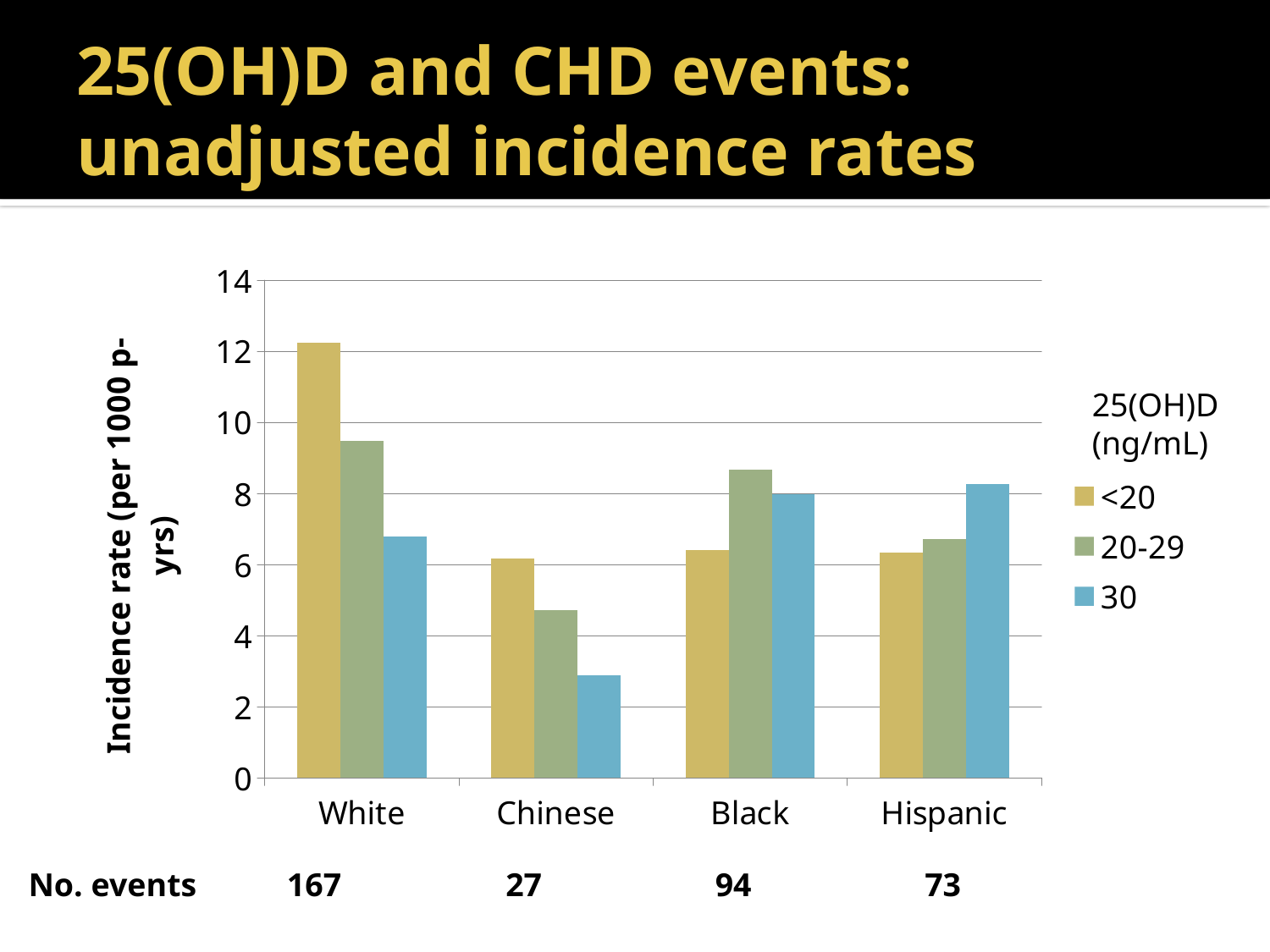
How many race/ethnicity categories are shown on the x axis? 4 Is the incidence rate for White in the <20 ng/mL group greater or less than 10? greater What is the title of the chart's legend? 25(OH)D (ng/mL) How many events are listed for the Black category? 94 For the Hispanic category, do the incidence rates rise or fall going from the <20 group to the 30 group? rise Is the incidence rate for Chinese in the 30 ng/mL group greater or less than 4? less How many 25(OH)D series does the legend list? 3 Which category has the lowest incidence rate for the 30 ng/mL group? Chinese Which is larger, the <20 ng/mL incidence rate for White or for Chinese? White Which category has the highest incidence rate for the <20 ng/mL group? White What kind of chart is shown on the slide? bar chart Is the incidence rate for Black in the 20-29 ng/mL group greater or less than 8? greater